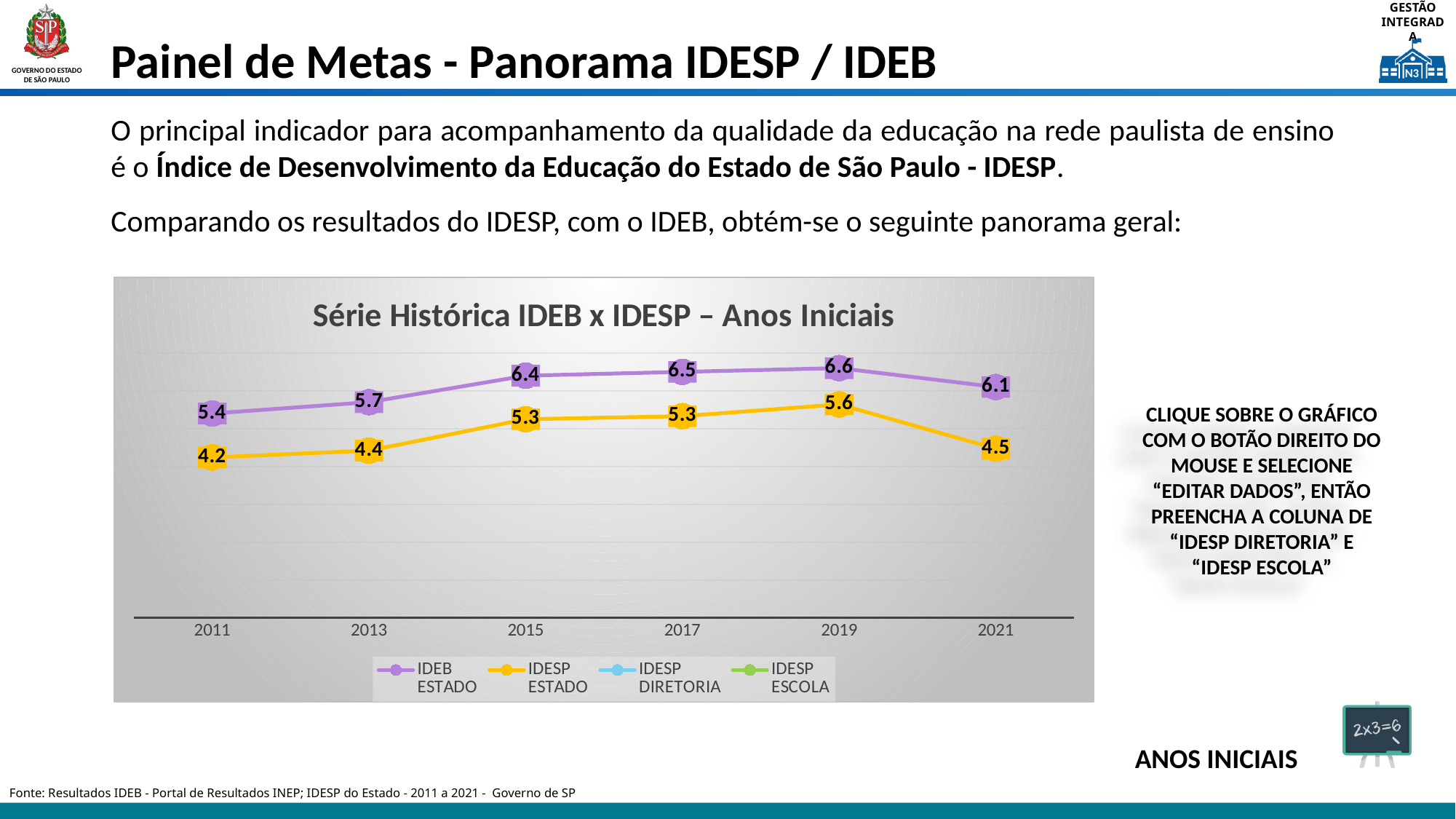
Does the IDEB ESTADO value rise or fall from 2011 to 2019? rise In which year is the IDEB ESTADO value highest? 2019 What is the title of the chart? Série Histórica IDEB x IDESP – Anos Iniciais What is the IDEB ESTADO value for 2019? 6.6 What is the IDESP ESTADO value for 2021? 4.5 Which is larger in 2015: the IDEB ESTADO value or the IDESP ESTADO value? IDEB ESTADO What kind of chart is shown? line chart What is the IDESP ESTADO value for 2011? 4.2 In which year is the IDESP ESTADO value lowest? 2011 How many series does the legend list? 4 What is the difference between the IDEB ESTADO and IDESP ESTADO values in 2021? 1.6 How many years are shown on the x axis? 6